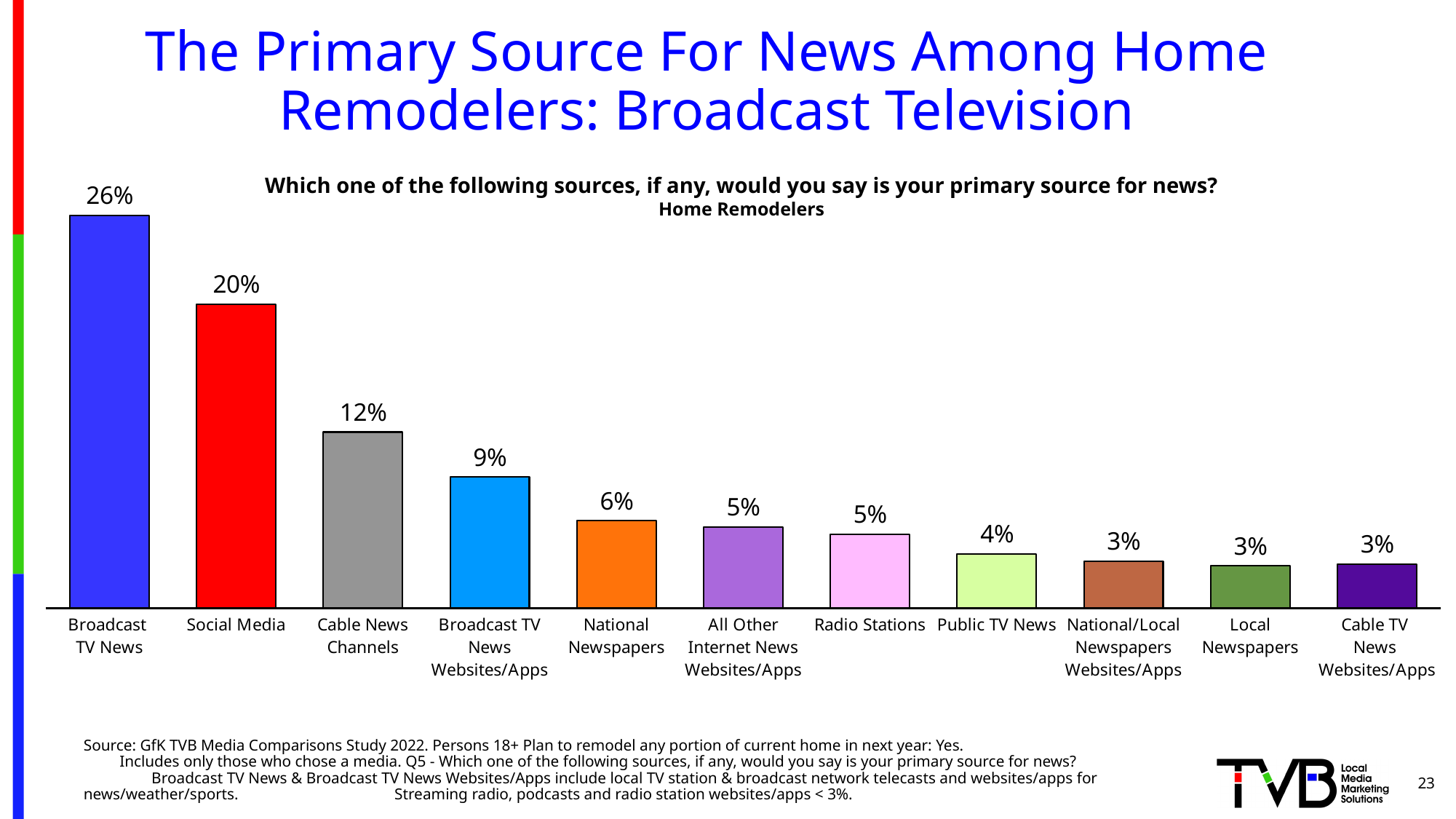
What is the difference between the values for Broadcast TV News and Social Media? 6% What percentage of home remodelers say Broadcast TV News is their primary source for news? 26% Do the values rise or fall moving from left to right across the chart? Fall How many sources (categories) are shown in the chart? 11 What is the value shown for Cable News Channels? 12% What percentage is shown for Broadcast TV News Websites/Apps? 9% What is the value for Public TV News? 4% What is the value shown for Social Media? 20% Which is larger, the value for Radio Stations or the value for Public TV News? Radio Stations What kind of chart is shown on the slide? Bar chart Which source has the highest value in the chart? Broadcast TV News What is the difference between the values for Cable News Channels and National Newspapers? 6%